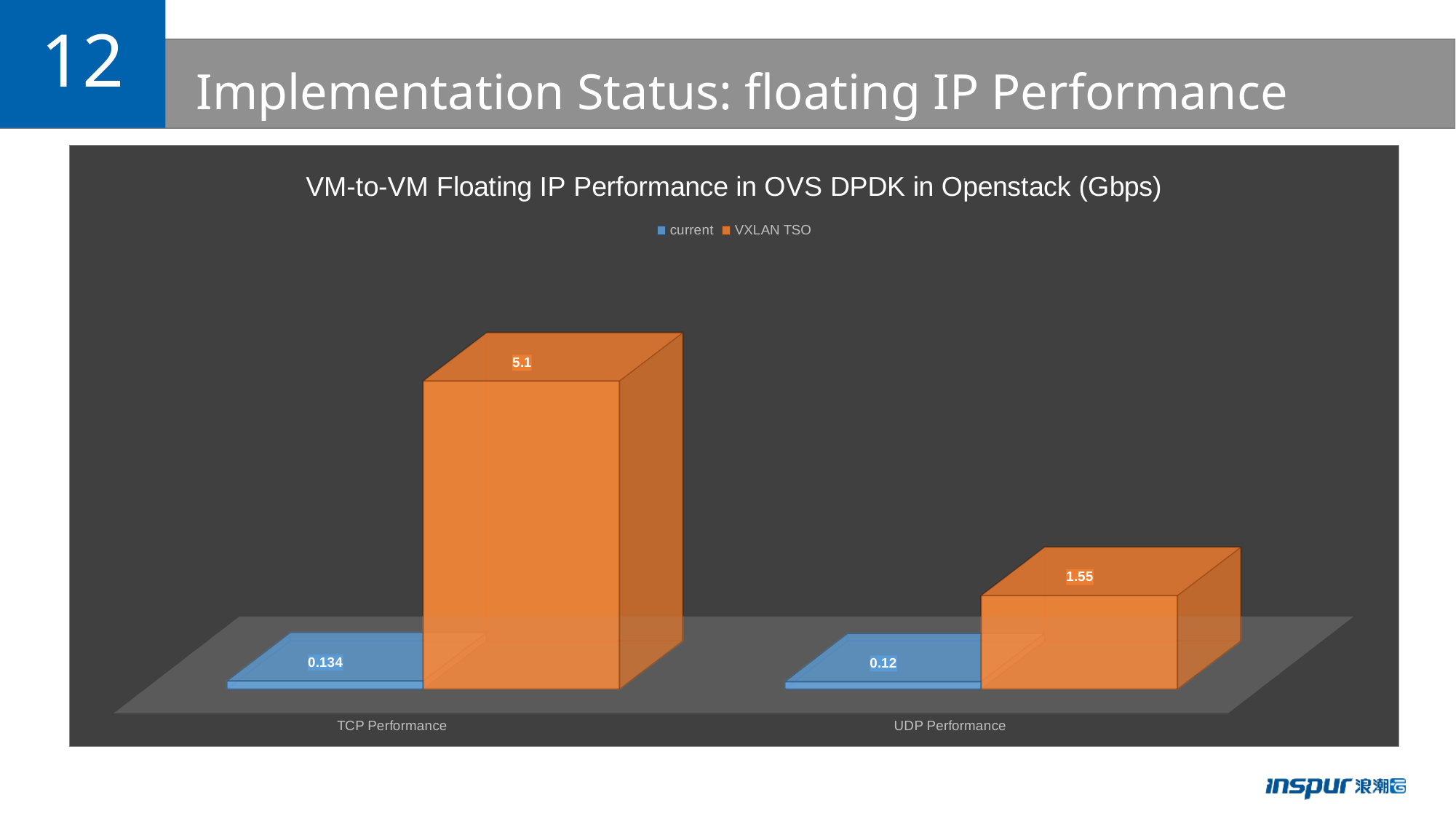
Which category has the lowest current value? UDP Performance Which category has the highest VXLAN TSO value? TCP Performance What is the value for VXLAN TSO in TCP Performance? 5.1 What kind of chart is shown on the slide? Bar chart What is the title of the chart? VM-to-VM Floating IP Performance in OVS DPDK in Openstack (Gbps) What is the value for current in TCP Performance? 0.134 What is the difference between the VXLAN TSO values for TCP Performance and UDP Performance? 3.55 What is the value for VXLAN TSO in UDP Performance? 1.55 What is the value for current in UDP Performance? 0.12 Which is larger in UDP Performance: current or VXLAN TSO? VXLAN TSO How many series does the legend list? 2 How many categories are shown on the x axis? 2